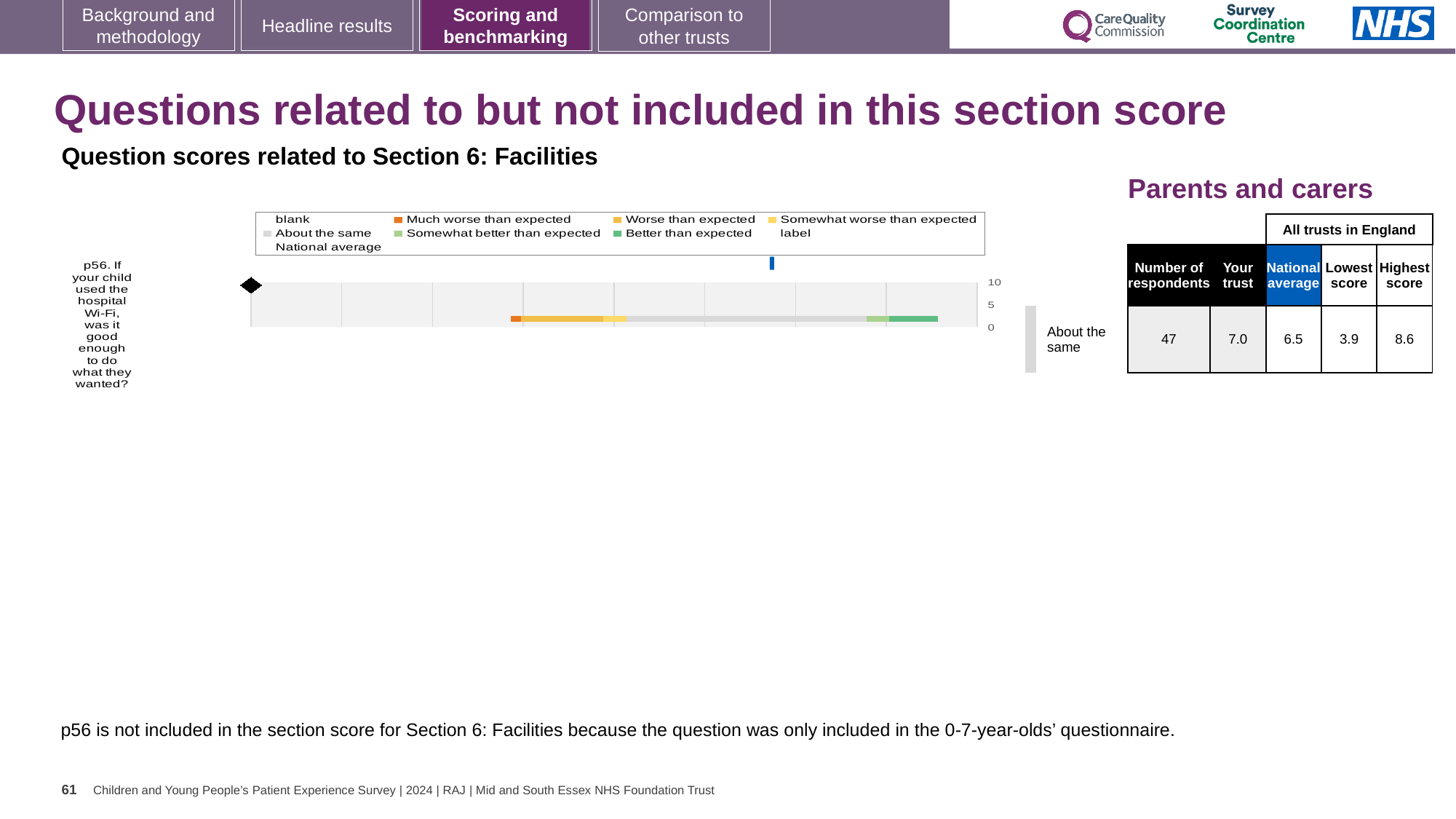
Is the national average marker on the p56 chart greater or less than 5? greater How many questions are plotted in the chart? 1 Which is higher for p56: the 'Your trust' score or the national average? Your trust How many respondents answered p56? 47 What kind of chart is used to show the p56 question score? bar chart What is the lowest score among all trusts in England for p56? 3.9 What is the national average score for p56? 6.5 What is the 'Your trust' score for p56 (hospital Wi-Fi)? 7.0 What is the difference between the highest score and the lowest score for p56? 4.7 In the chart legend, which colour represents 'Much worse than expected'? orange What is the highest score among all trusts in England for p56? 8.6 In the chart legend, which colour represents 'Better than expected'? green